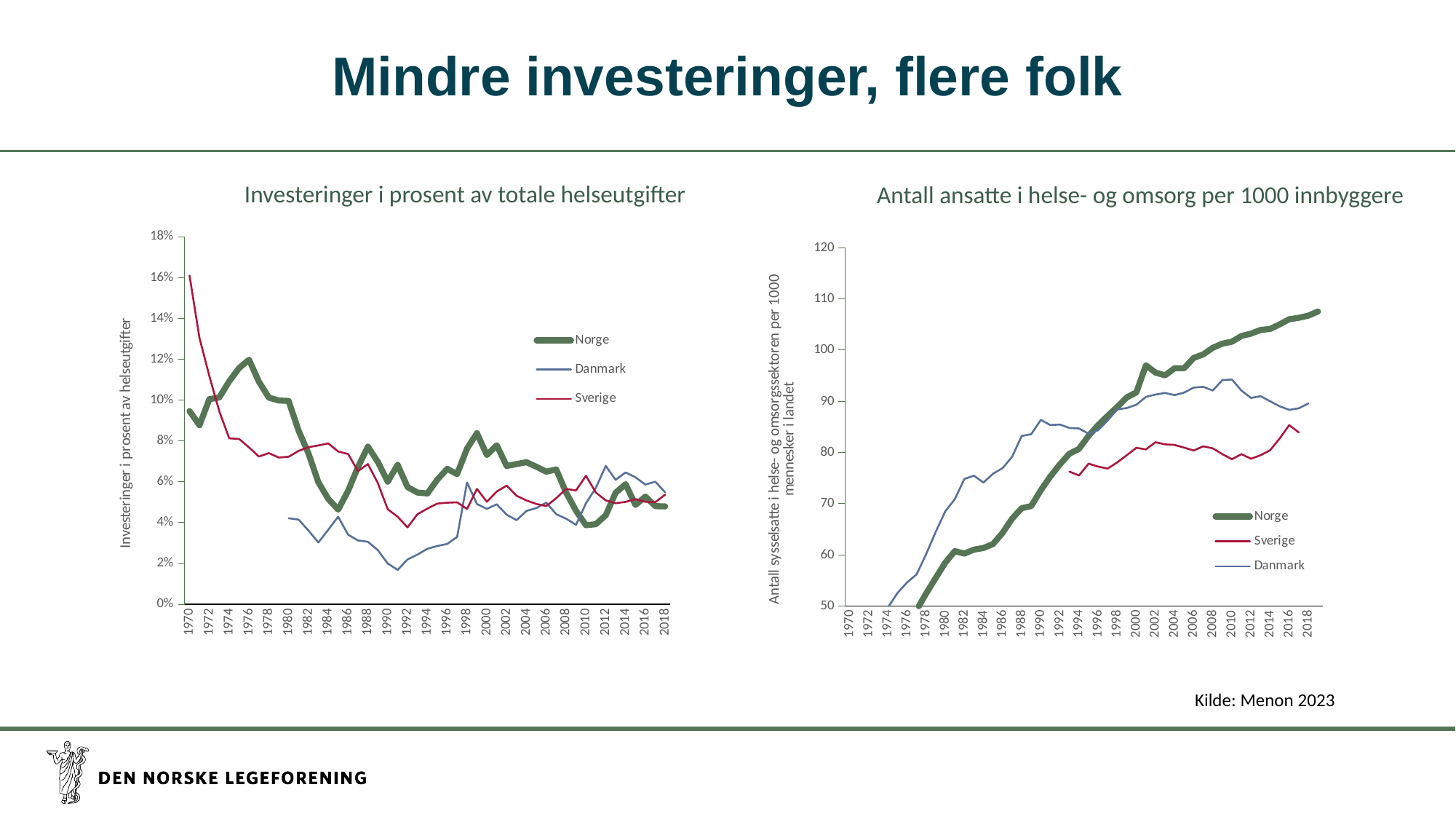
How many series does the legend of the right chart, 'Antall ansatte i helse- og omsorg per 1000 innbyggere', list? 3 In the left chart, 'Investeringer i prosent av totale helseutgifter', is the value for Sverige in 1970 greater or less than 14%? greater In the right chart, 'Antall ansatte i helse- og omsorg per 1000 innbyggere', is the value for Norge in 2018 greater or less than 100? greater In the left chart, 'Investeringer i prosent av totale helseutgifter', does the Sverige series generally rise or fall from 1970 to 2018? fall What is the title of the right chart on the slide? Antall ansatte i helse- og omsorg per 1000 innbyggere In the right chart, 'Antall ansatte i helse- og omsorg per 1000 innbyggere', does the Norge series generally rise or fall from 1978 to 2018? rise How many series does the legend of the left chart, 'Investeringer i prosent av totale helseutgifter', list? 3 In the right chart, 'Antall ansatte i helse- og omsorg per 1000 innbyggere', is the value for Sverige in 2016 greater or less than 90? less What kind of chart is the left chart, 'Investeringer i prosent av totale helseutgifter'? line chart In the left chart, 'Investeringer i prosent av totale helseutgifter', which series has the higher value in 1976, Norge or Sverige? Norge In the right chart, 'Antall ansatte i helse- og omsorg per 1000 innbyggere', which series has the higher value in 2018, Norge or Danmark? Norge